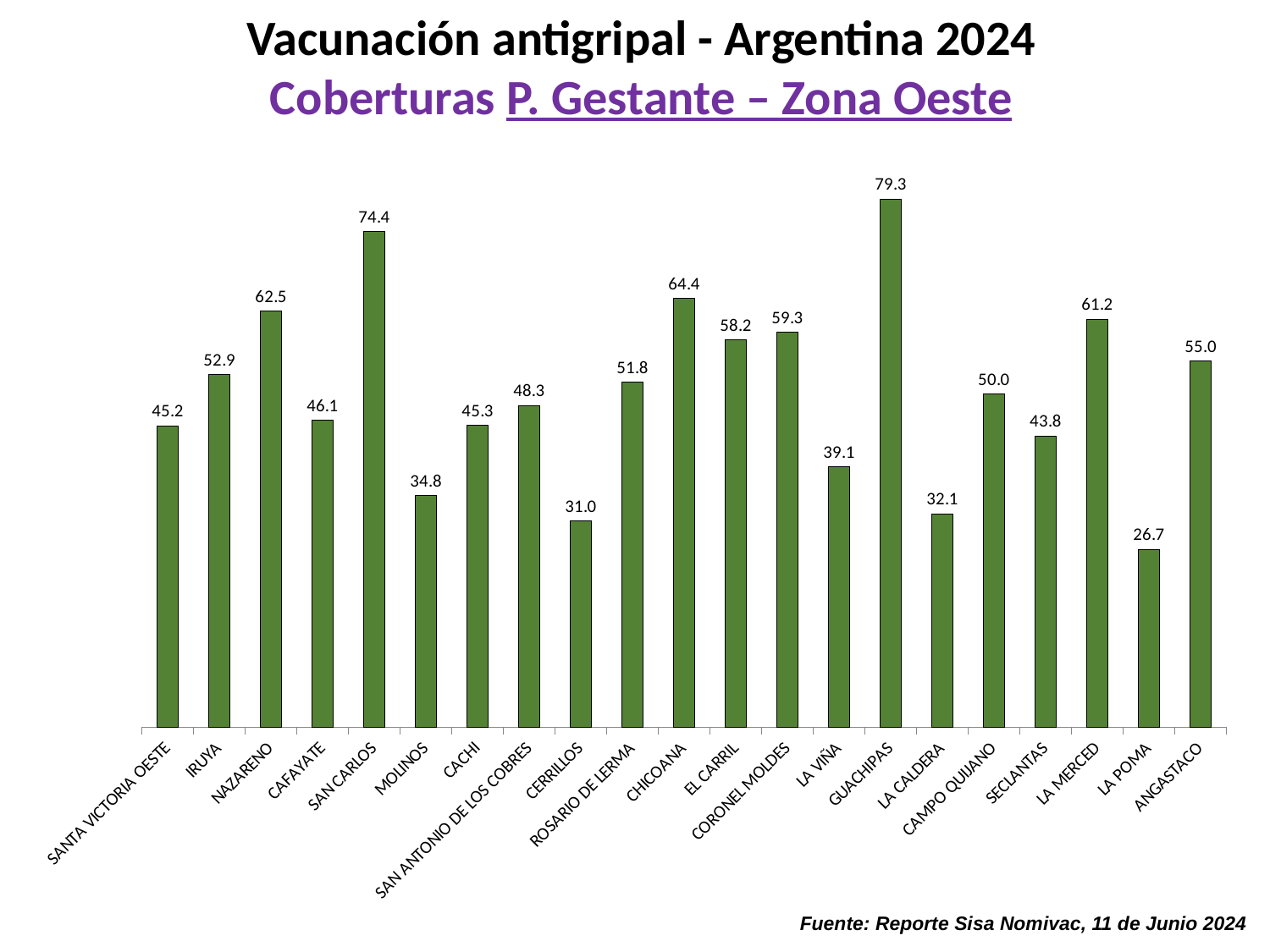
Which category has the highest value? GUACHIPAS Which category has the lowest value? LA POMA Which is larger, the value for CHICOANA or the value for LA MERCED? CHICOANA How many categories are shown on the x axis? 21 What is the value for CAMPO QUIJANO? 50.0 What is the value for LA POMA? 26.7 What is the difference between the values for GUACHIPAS and LA POMA? 52.6 Which is larger, the value for IRUYA or the value for CAFAYATE? IRUYA What is the value for SAN ANTONIO DE LOS COBRES? 48.3 What is the difference between the values for SAN CARLOS and NAZARENO? 11.9 What kind of chart is shown on the slide? Bar chart What is the value for GUACHIPAS? 79.3